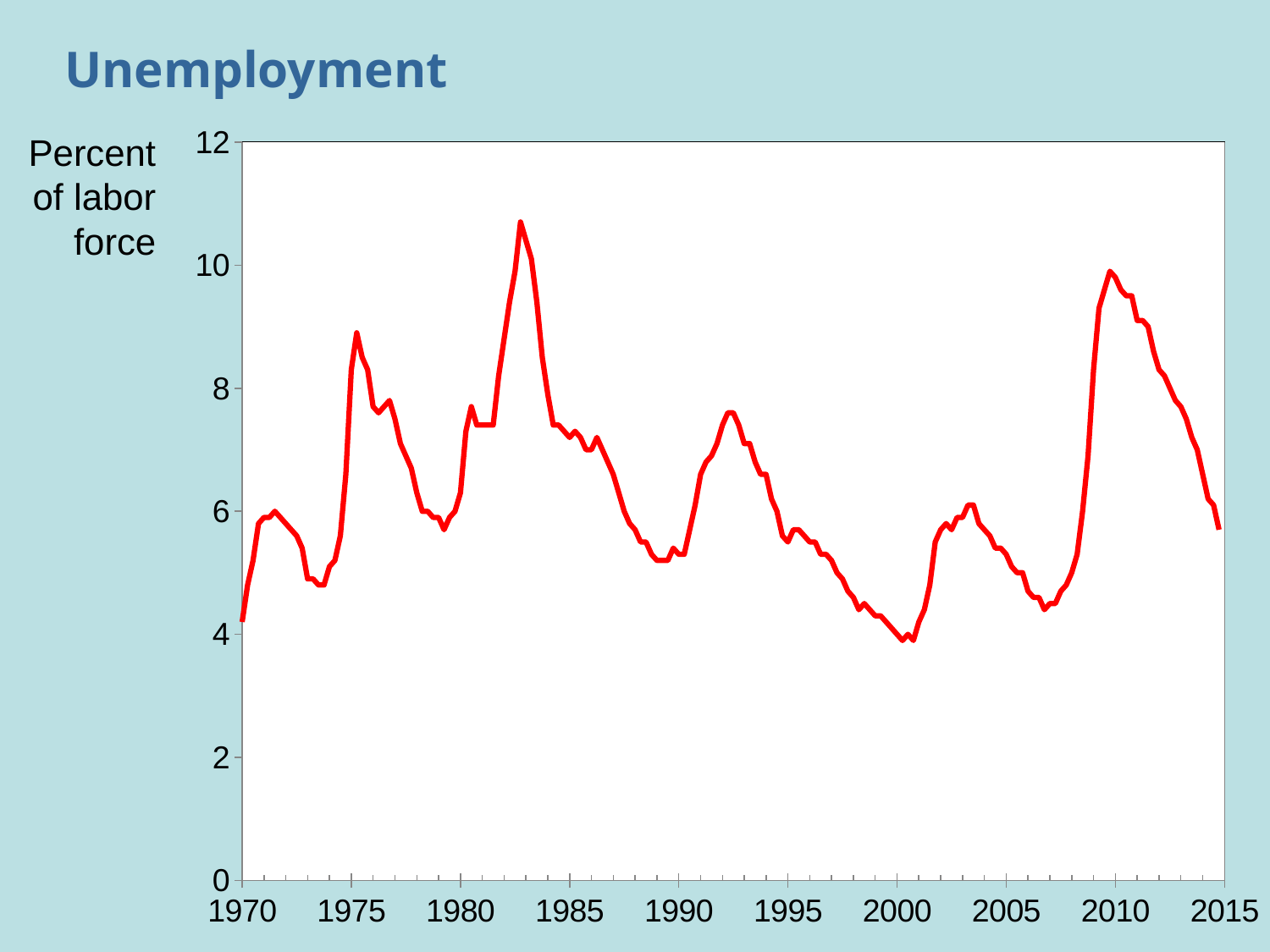
Does the unemployment rate rise or fall between 2007 and 2009? rise Is the unemployment rate in 1983 greater or less than 10? greater Which peak is higher, the one around 1983 or the one around 2010? around 1983 What is the label on the vertical axis of the chart? Percent of labor force Does the unemployment rate rise or fall between 2010 and 2015? fall What is the title of the chart? Unemployment What kind of chart is shown on the slide? line chart Is the unemployment rate in 2007 greater or less than 6? less Is the unemployment rate in 2010 greater or less than 8? greater Around which year does the unemployment rate reach its highest point? 1983